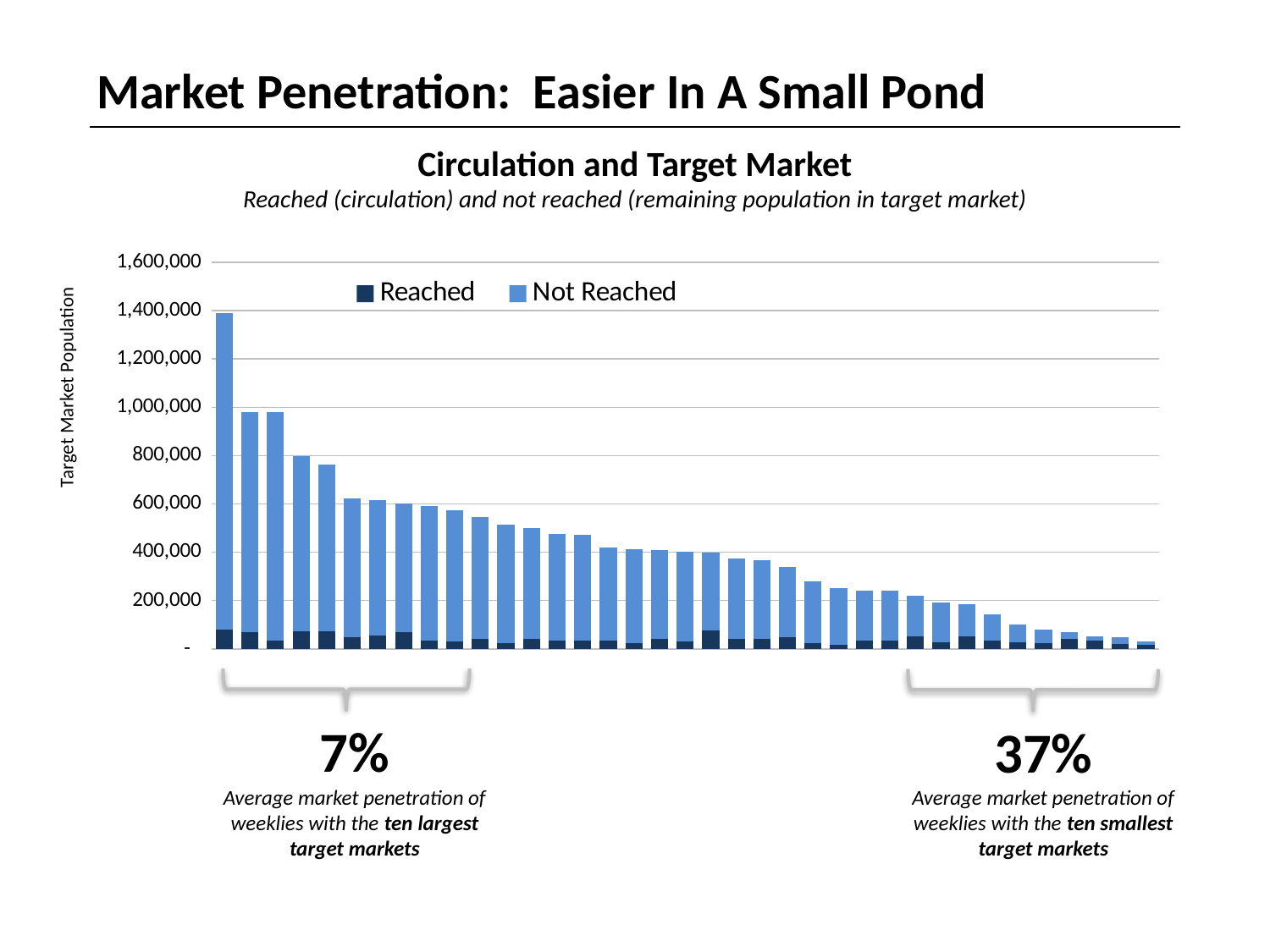
Is the total value of the rightmost bar greater or less than 200,000? less How many series does the chart's legend list? 2 What are the two series named in the chart's legend? Reached and Not Reached Is the total value of the leftmost bar greater or less than the total value of the second bar from the left? greater According to the annotation below the chart, what is the average market penetration of weeklies with the ten smallest target markets? 37% What is the highest value shown on the chart's vertical axis? 1,600,000 What kind of chart is shown on the slide? stacked bar chart Do the total bar heights rise or fall moving from left to right along the x axis? fall Is the total value of the leftmost bar greater or less than 1,200,000? greater Is the total value of the fourth bar from the left greater or less than 600,000? greater Which bar has the largest total target market population? the leftmost (first) bar